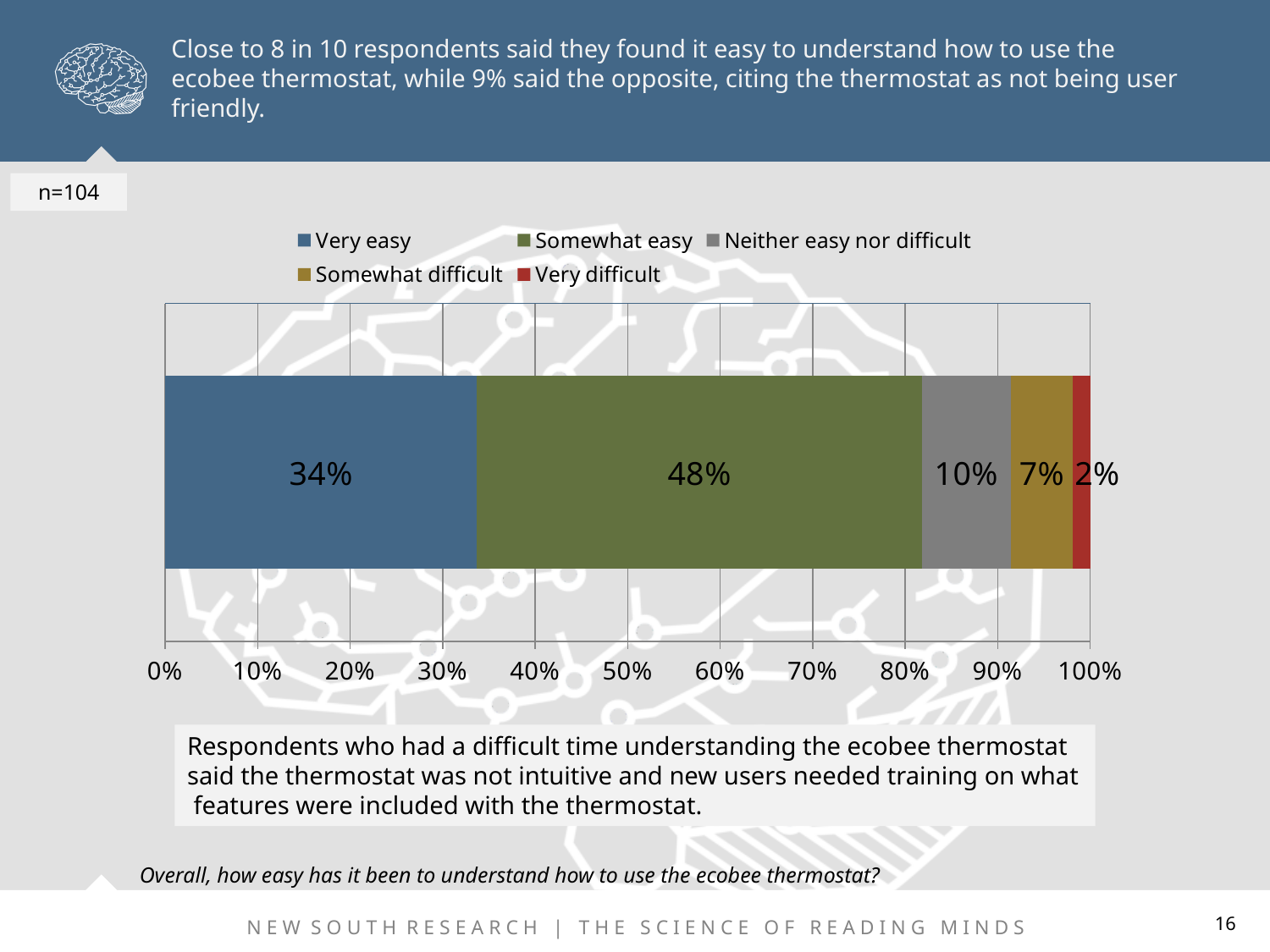
Which response category has the largest share? Somewhat easy Which response category has the smallest share? Very difficult What percentage of respondents said it was somewhat difficult? 7% What percentage of respondents said it was somewhat easy? 48% How many series does the legend list? 5 What kind of chart is shown on the slide? Stacked bar chart What percentage of respondents said it was very difficult? 2% What is the combined percentage of respondents who said very easy or somewhat easy? 82% Which is larger, the share for neither easy nor difficult or the share for somewhat difficult? Neither easy nor difficult What percentage of respondents said it was very easy to understand how to use the ecobee thermostat? 34% What percentage of respondents said it was neither easy nor difficult? 10% What is the difference in percentage points between the somewhat easy and very easy segments? 14